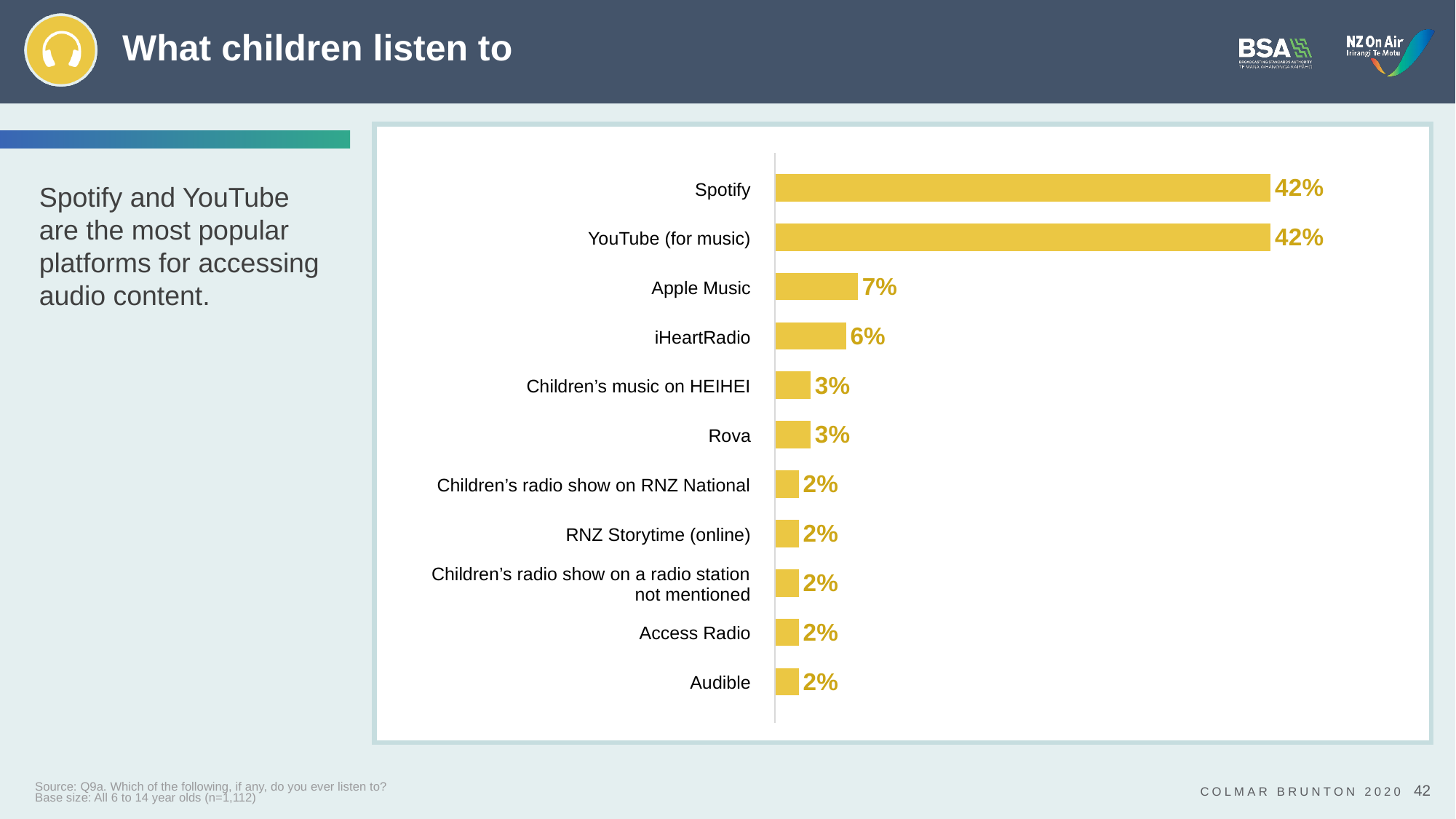
What is the value shown for Apple Music? 7% What kind of chart is shown on the slide? Bar chart What is the difference between the values for Spotify and Apple Music? 35% What percentage of children listen to Rova? 3% How many categories are shown in the chart? 11 What percentage of children listen to Spotify? 42% What is the difference between the values for Apple Music and iHeartRadio? 1% What is the value shown for Audible? 2% What is the value shown for iHeartRadio? 6% Which is larger, the value for Apple Music or the value for Children's music on HEIHEI? Apple Music What is the title of the slide containing the chart? What children listen to